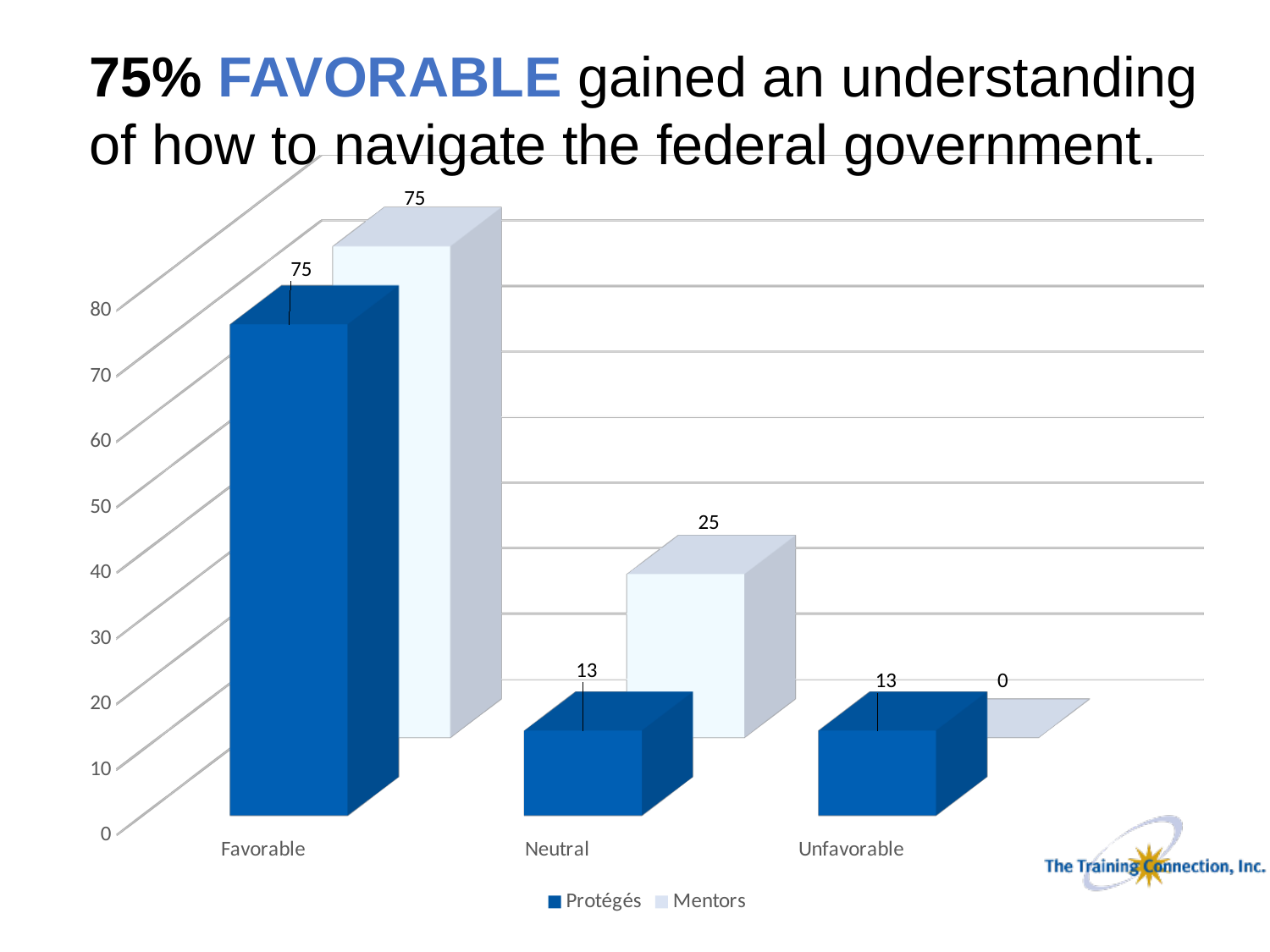
What is the difference between the Mentors value for Favorable and the Mentors value for Neutral? 50 Which category has the highest value for Mentors? Favorable How many categories are shown on the x axis? 3 In the Neutral category, which series has the larger value, Protégés or Mentors? Mentors Which category has the lowest value for Mentors? Unfavorable How many series does the legend list? 2 What is the value for Mentors in the Unfavorable category? 0 What is the value for Protégés in the Favorable category? 75 What is the value for Protégés in the Unfavorable category? 13 Do the Protégés values rise or fall from Favorable to Unfavorable? Fall What is the value for Mentors in the Neutral category? 25 What kind of chart is shown on the slide? Bar chart